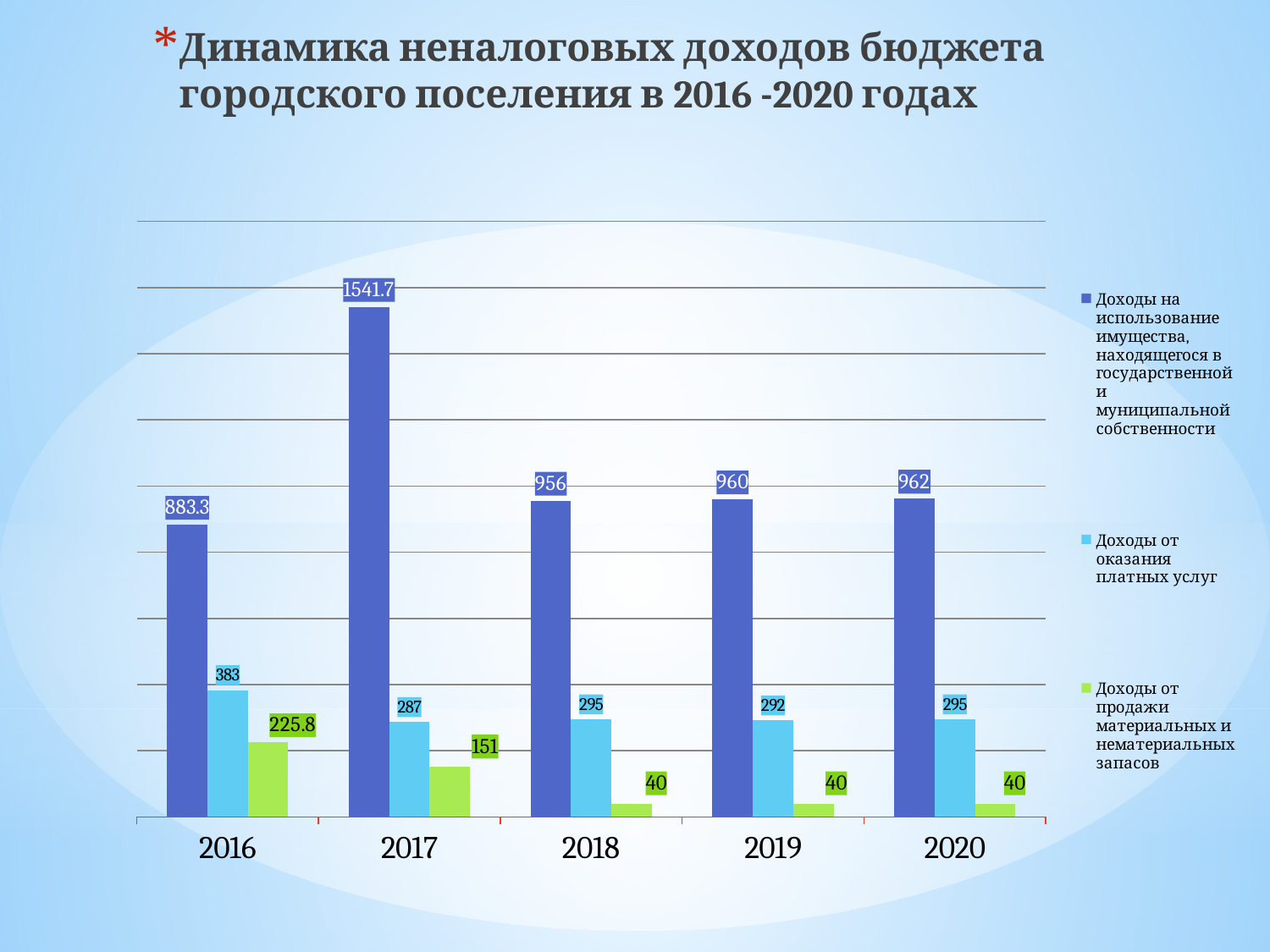
By how much does 'Доходы на использование имущества, находящегося в государственной и муниципальной собственности' in 2017 exceed the value in 2016? 658.4 How many series does the legend list? 3 What kind of chart is shown on the slide? bar chart How many years are shown on the x axis of the chart? 5 Which year has the larger value for 'Доходы от продажи материальных и нематериальных запасов', 2016 or 2017? 2016 What is the value of 'Доходы от продажи материальных и нематериальных запасов' in 2020? 40 In which year is 'Доходы на использование имущества, находящегося в государственной и муниципальной собственности' the highest? 2017 Does 'Доходы на использование имущества, находящегося в государственной и муниципальной собственности' rise or fall from 2018 to 2020? rise What is the value of 'Доходы на использование имущества, находящегося в государственной и муниципальной собственности' in 2017? 1541.7 What is the difference between 'Доходы от продажи материальных и нематериальных запасов' in 2016 and in 2017? 74.8 What is the value of 'Доходы от оказания платных услуг' in 2016? 383 In which year is 'Доходы от оказания платных услуг' the lowest? 2017